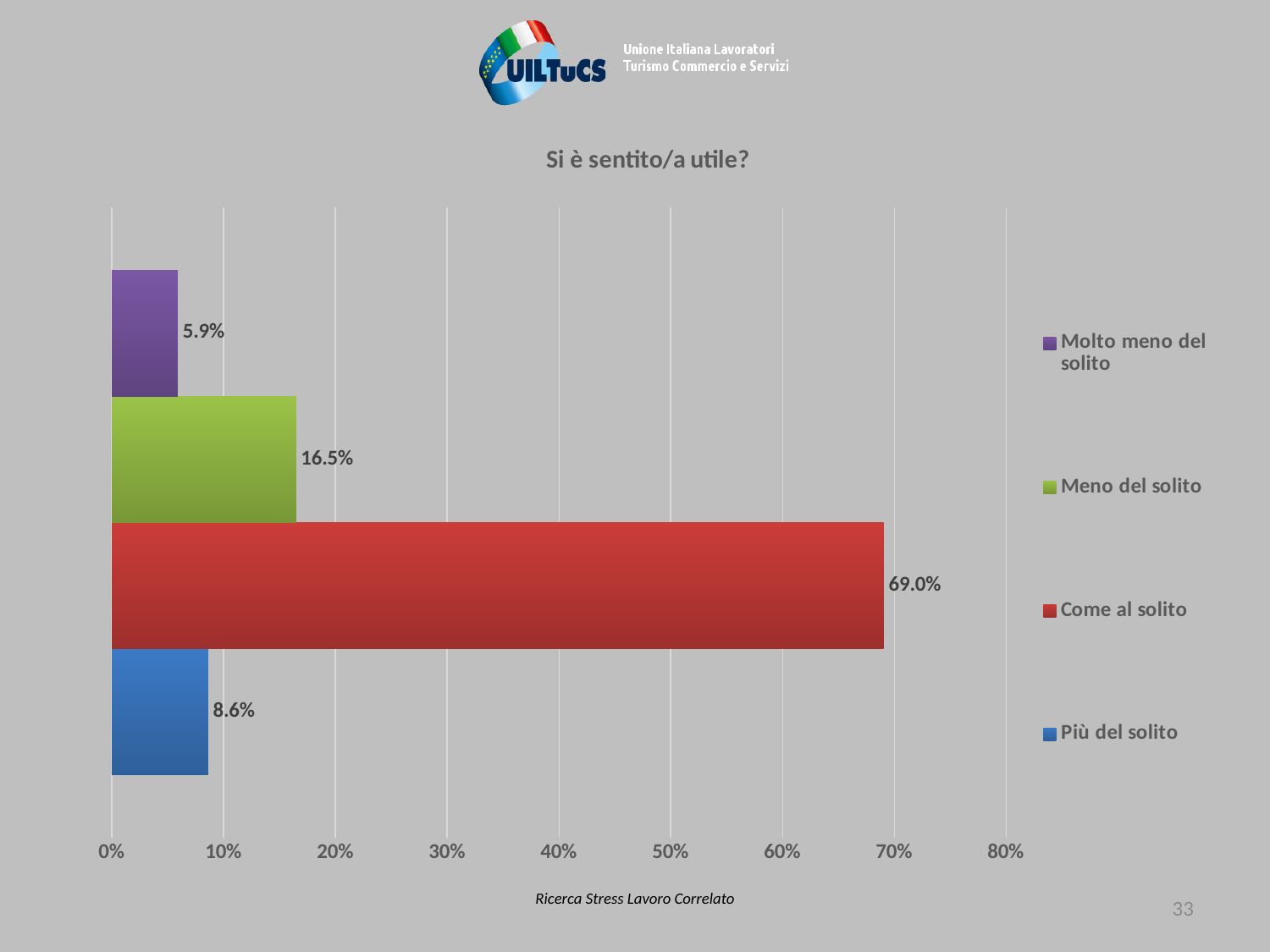
What is the value for "Come al solito"? 69.0% Which category has the lowest value? Molto meno del solito Which category has the highest value? Come al solito Which is larger, the value for "Più del solito" or the value for "Molto meno del solito"? Più del solito How many categories does the legend list? 4 What is the value for "Meno del solito"? 16.5% What is the value for "Più del solito"? 8.6% What is the value for "Molto meno del solito"? 5.9% What kind of chart is shown on the slide? bar chart What is the difference between the values for "Come al solito" and "Meno del solito"? 52.5% Is the value for "Meno del solito" greater or less than 20%? less What is the title of the chart? Si è sentito/a utile?